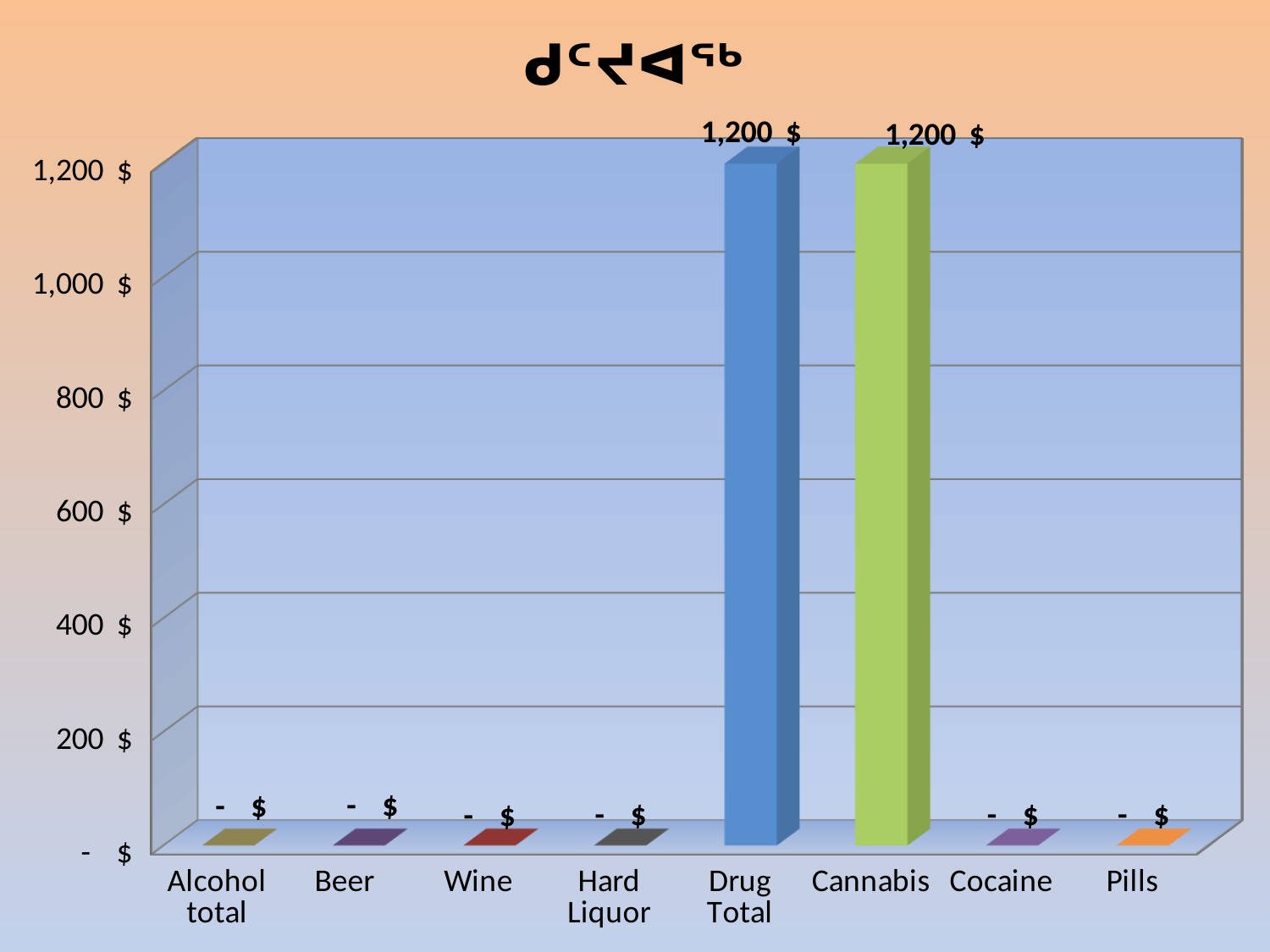
What colour is the Cannabis bar? green Which is larger, the value for Cannabis or the value for Wine? Cannabis How many categories are shown on the x axis? 8 Is the value for Cannabis greater or less than 1,000 $? greater Which is larger, the value for Drug Total or the value for Cocaine? Drug Total Which two categories have the highest values? Drug Total and Cannabis What is the value for Drug Total? 1,200 $ What data label is shown above the Beer bar? - $ What colour is the Drug Total bar? blue What kind of chart is shown on the slide? bar chart Is the value for Pills greater or less than 200 $? less What is the value for Cannabis? 1,200 $